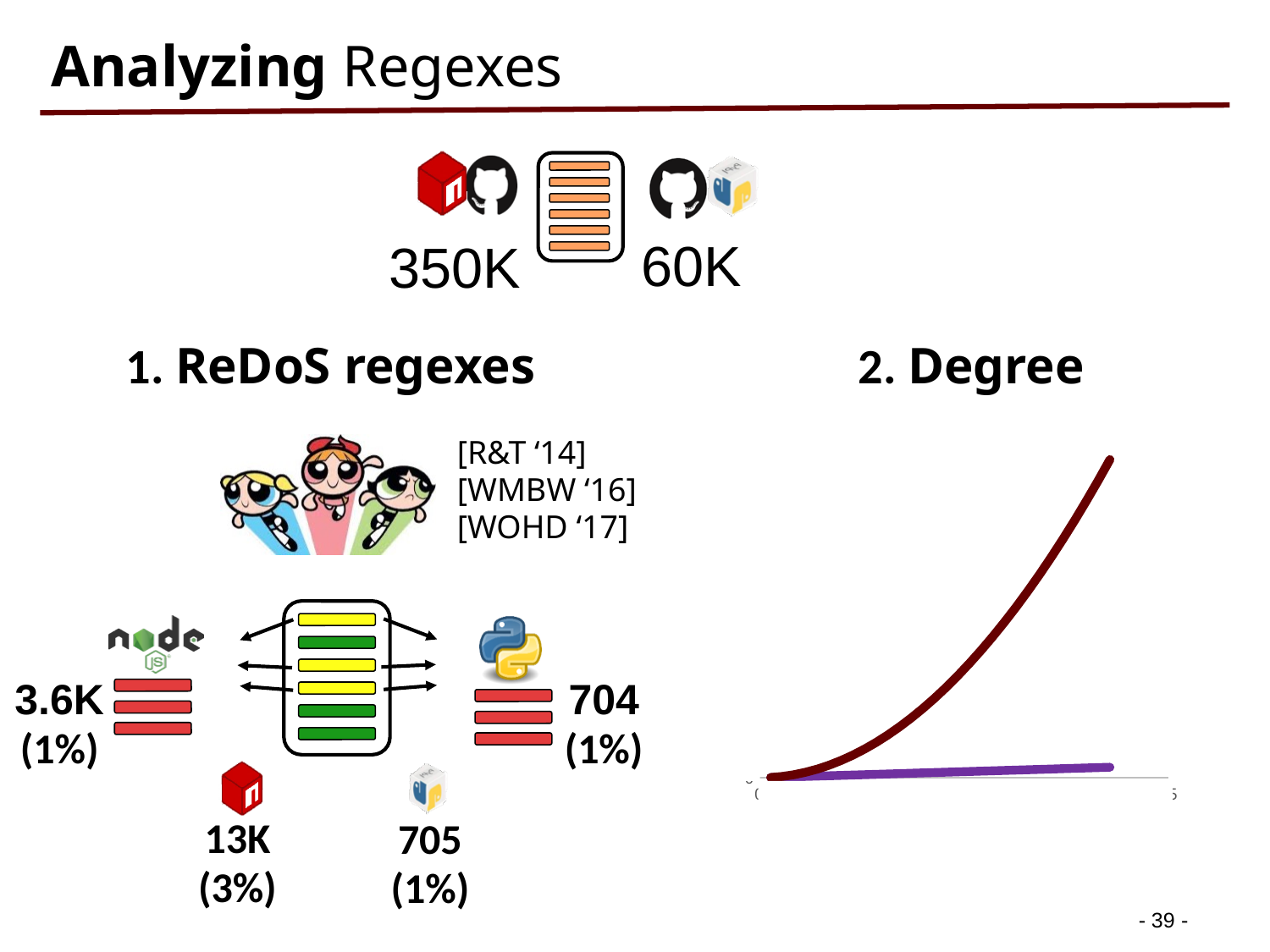
In the chart under "2. Degree", how many lines are plotted? 2 In the chart under "2. Degree", does the dark red line rise or fall as it moves along the x axis? rise What kind of chart is shown under the heading "2. Degree"? line chart In the chart under "2. Degree", which line stays nearly flat along the x axis? the purple line In the chart under "2. Degree", what colour is the line that curves steeply upward? dark red In the chart under "2. Degree", which line reaches the higher value at the right end of the x axis, the dark red line or the purple line? the dark red line